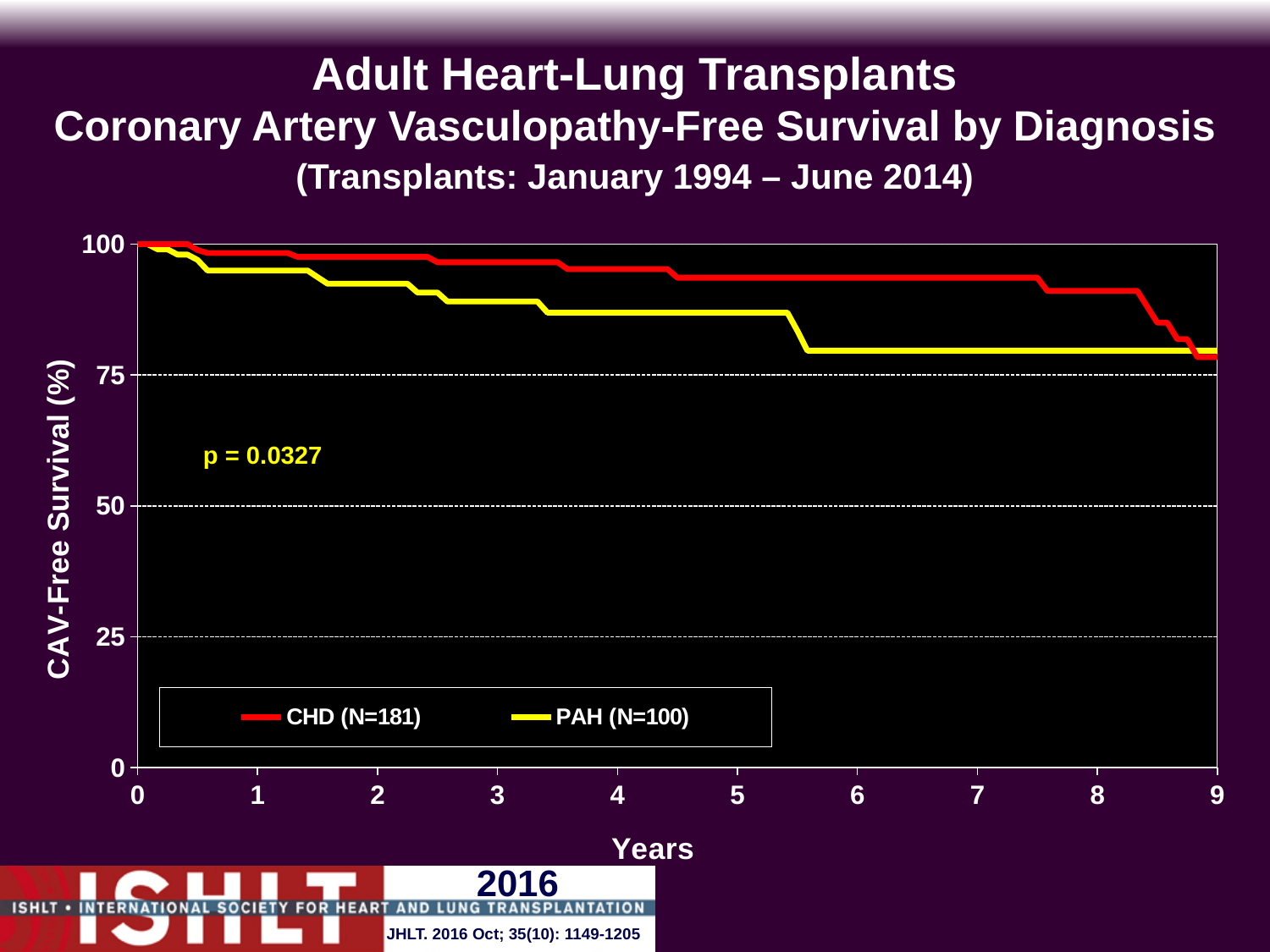
What is the N for the CHD group shown in the legend? 181 Do the survival curves rise or fall as years increase along the x axis? fall What is the N for the PAH group shown in the legend? 100 How many series does the legend list? 2 What p-value is printed on the chart? p = 0.0327 What is the CAV-free survival value for both groups at year 0? 100 At 3 years, which group has the higher CAV-free survival, CHD or PAH? CHD Is the CAV-free survival for CHD at 5 years greater or less than 75? greater What kind of chart is shown on the slide? line chart Is the CAV-free survival for PAH at 8 years greater or less than 50? greater Which colour represents the PAH group in the chart? yellow What is the maximum number of years shown on the x axis? 9